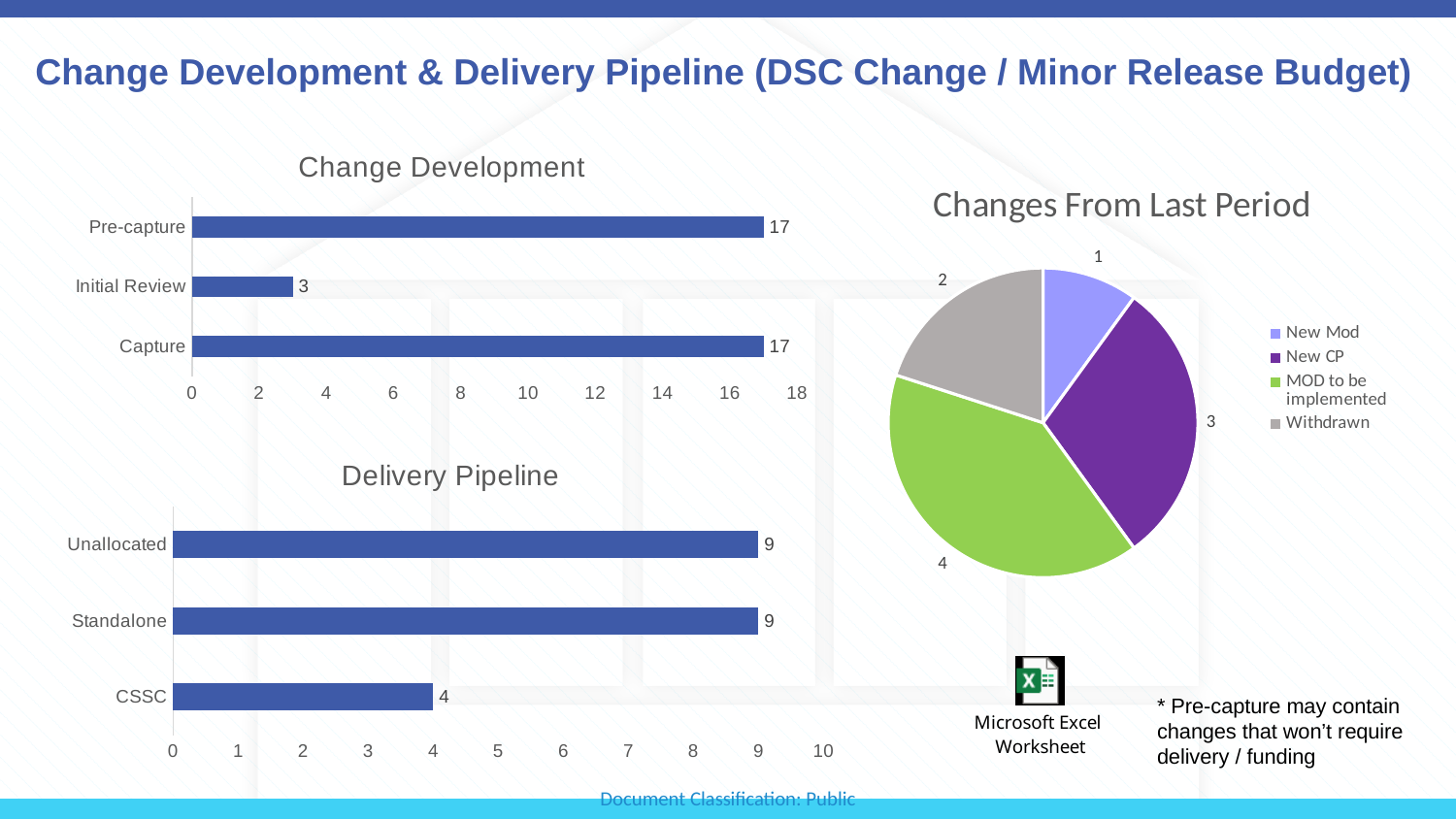
What kind of chart is the Delivery Pipeline chart? Bar chart In the Changes From Last Period chart, what is the value for New CP? 3 How many entries does the legend of the Changes From Last Period chart list? 4 In the Change Development chart, what is the value for Pre-capture? 17 In the Delivery Pipeline chart, which is larger, Standalone or CSSC? Standalone In the Change Development chart, what is the value for Initial Review? 3 In the Change Development chart, what is the difference between Capture and Initial Review? 14 In the Delivery Pipeline chart, what is the value for CSSC? 4 In the Change Development chart, which category has the lowest value? Initial Review In the Changes From Last Period chart, what share of the total does MOD to be implemented represent? 40% In the Changes From Last Period chart, which category has the largest slice? MOD to be implemented In the Delivery Pipeline chart, how many categories are shown? 3